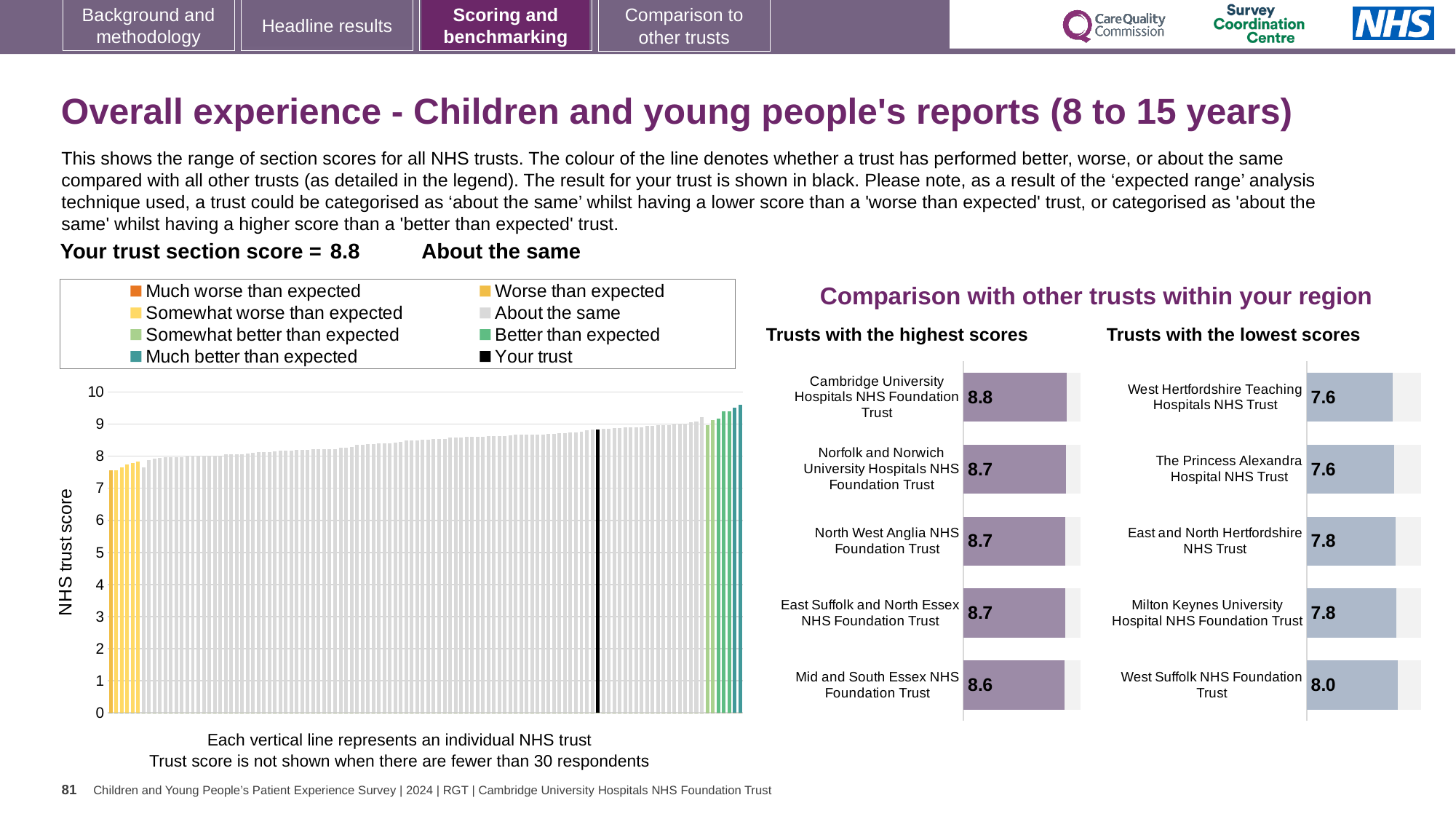
In the 'Trusts with the highest scores' chart, what is the difference between the scores of Cambridge University Hospitals NHS Foundation Trust and Mid and South Essex NHS Foundation Trust? 0.2 What kind of chart is the large chart on the left showing all NHS trusts? Bar chart In the 'Trusts with the highest scores' chart, what is the score for Cambridge University Hospitals NHS Foundation Trust? 8.8 In the 'Trusts with the lowest scores' chart, what is the score for West Suffolk NHS Foundation Trust? 8.0 What is the section score for your trust shown on the slide? 8.8 In the large chart on the left, do the trust scores rise or fall from left to right? Rise In the 'Trusts with the highest scores' chart, which trust has the lowest score? Mid and South Essex NHS Foundation Trust In the 'Trusts with the lowest scores' chart, which has the larger score: East and North Hertfordshire NHS Trust or West Hertfordshire Teaching Hospitals NHS Trust? East and North Hertfordshire NHS Trust In the 'Trusts with the lowest scores' chart, what is the difference between the scores of West Suffolk NHS Foundation Trust and The Princess Alexandra Hospital NHS Trust? 0.4 How many trusts are listed in the 'Trusts with the highest scores' chart? 5 In the 'Trusts with the lowest scores' chart, which trust has the highest score? West Suffolk NHS Foundation Trust How many entries does the legend above the large chart on the left list? 8